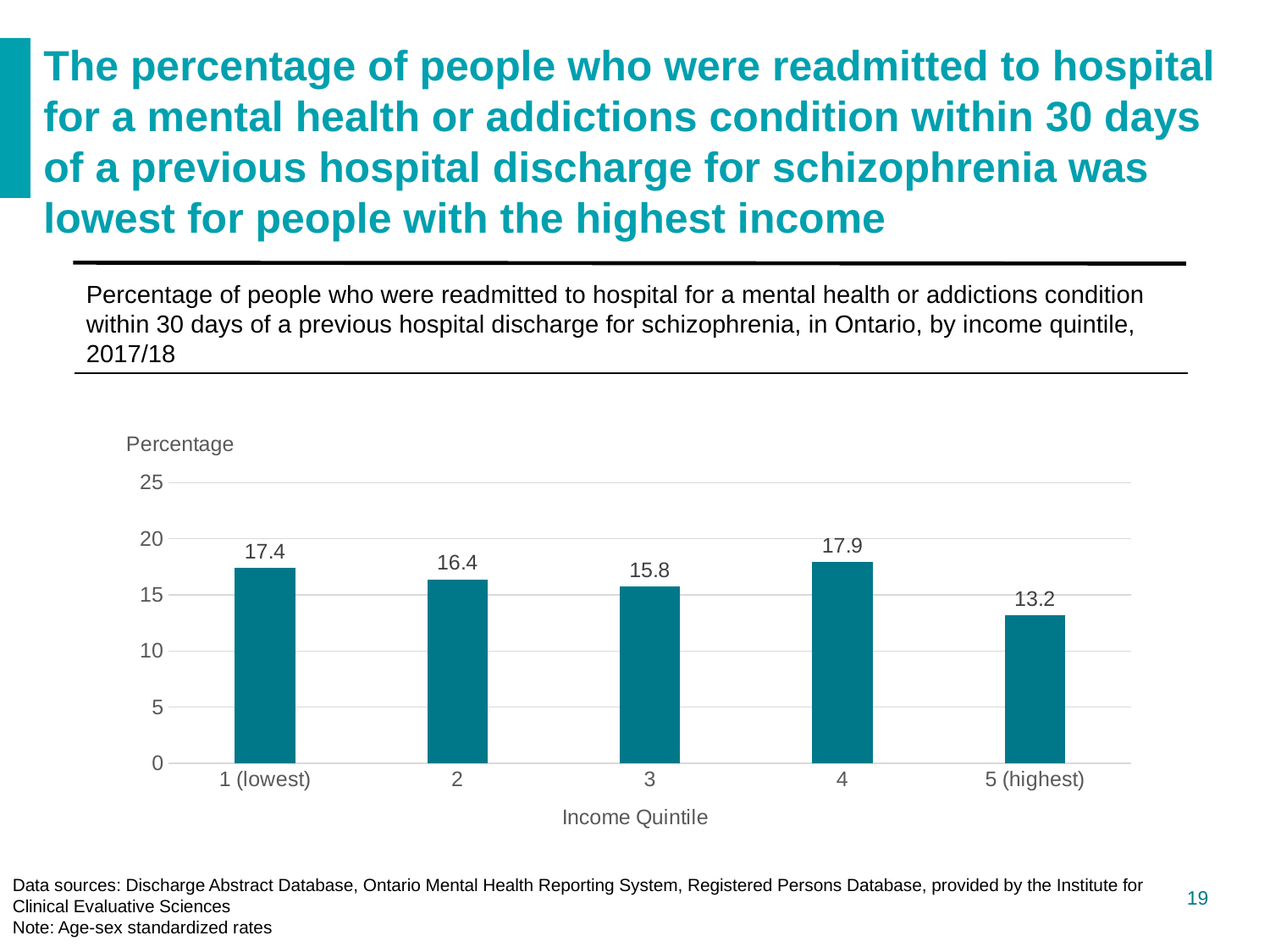
What is the difference between the readmission percentage for quintile 1 (lowest) and quintile 2? 1.0 What kind of chart is shown on the slide? bar chart What is the label of the x axis? Income Quintile Which income quintile has the highest readmission percentage? 4 Is the value for income quintile 5 (highest) greater or less than 15? less What is the readmission percentage for income quintile 5 (highest)? 13.2 Which has a higher readmission percentage, income quintile 2 or income quintile 3? 2 How many income quintiles are shown on the chart? 5 What is the readmission percentage for income quintile 3? 15.8 What is the difference between the readmission percentage for quintile 4 and quintile 5 (highest)? 4.7 What is the readmission percentage for income quintile 1 (lowest)? 17.4 Which income quintile has the lowest readmission percentage? 5 (highest)